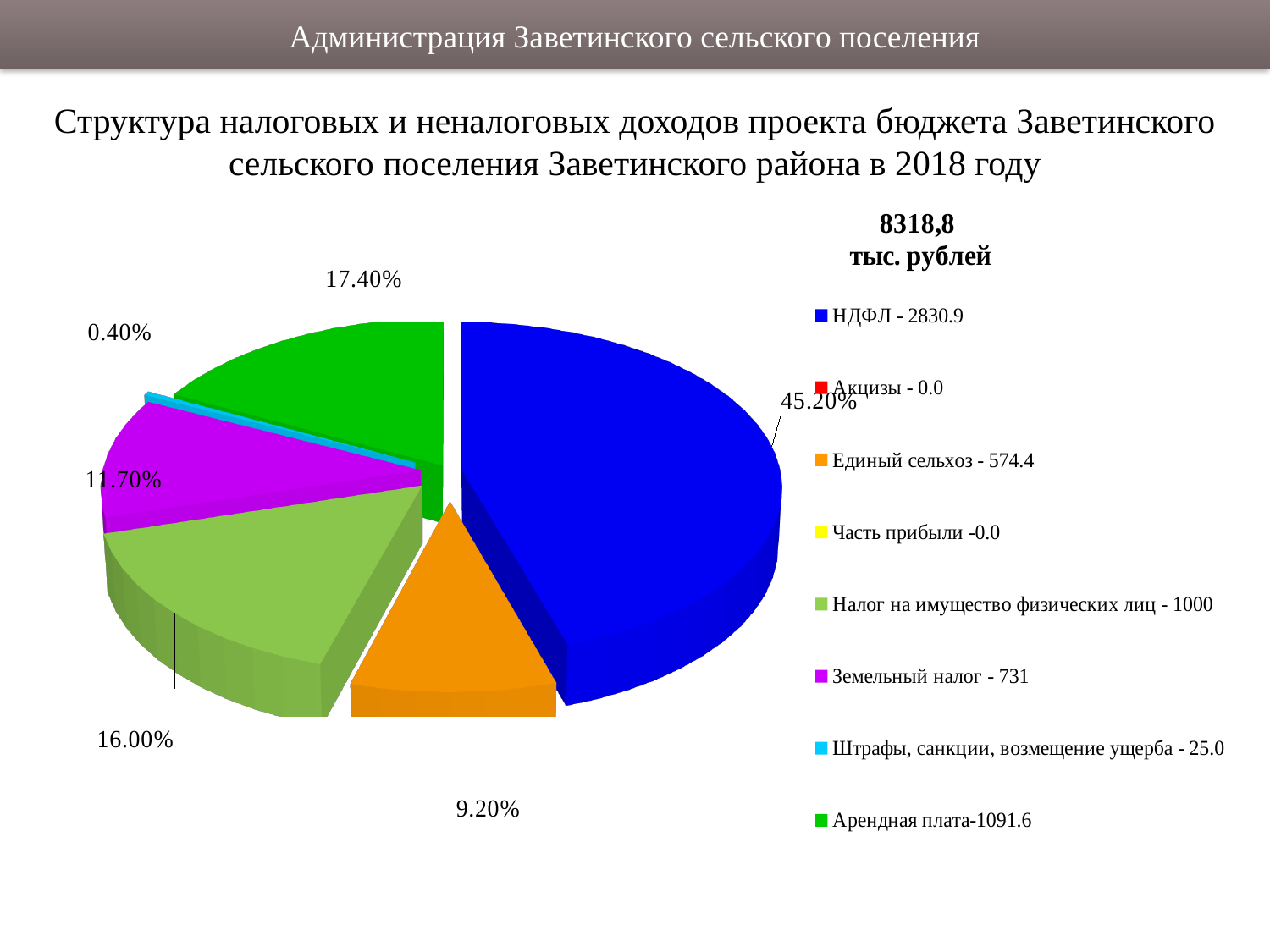
What percentage share is shown for the Земельный налог slice? 11.70% What kind of chart is shown on the slide? pie chart What total amount is printed above the legend? 8318,8 тыс. рублей What value does the legend give for Единый сельхоз? 574.4 What percentage share is shown for the Штрафы, санкции, возмещение ущерба slice? 0.40% What percentage share is shown for the НДФЛ slice? 45.20% What value does the legend give for Налог на имущество физических лиц? 1000 What percentage share is shown for the Арендная плата slice? 17.40% How many entries does the chart legend list? 8 Which category has the largest slice of the pie? НДФЛ Which slice is larger: Налог на имущество физических лиц or Земельный налог? Налог на имущество физических лиц What is the difference in percentage points between the НДФЛ slice (45.20%) and the Арендная плата slice (17.40%)? 27.80%